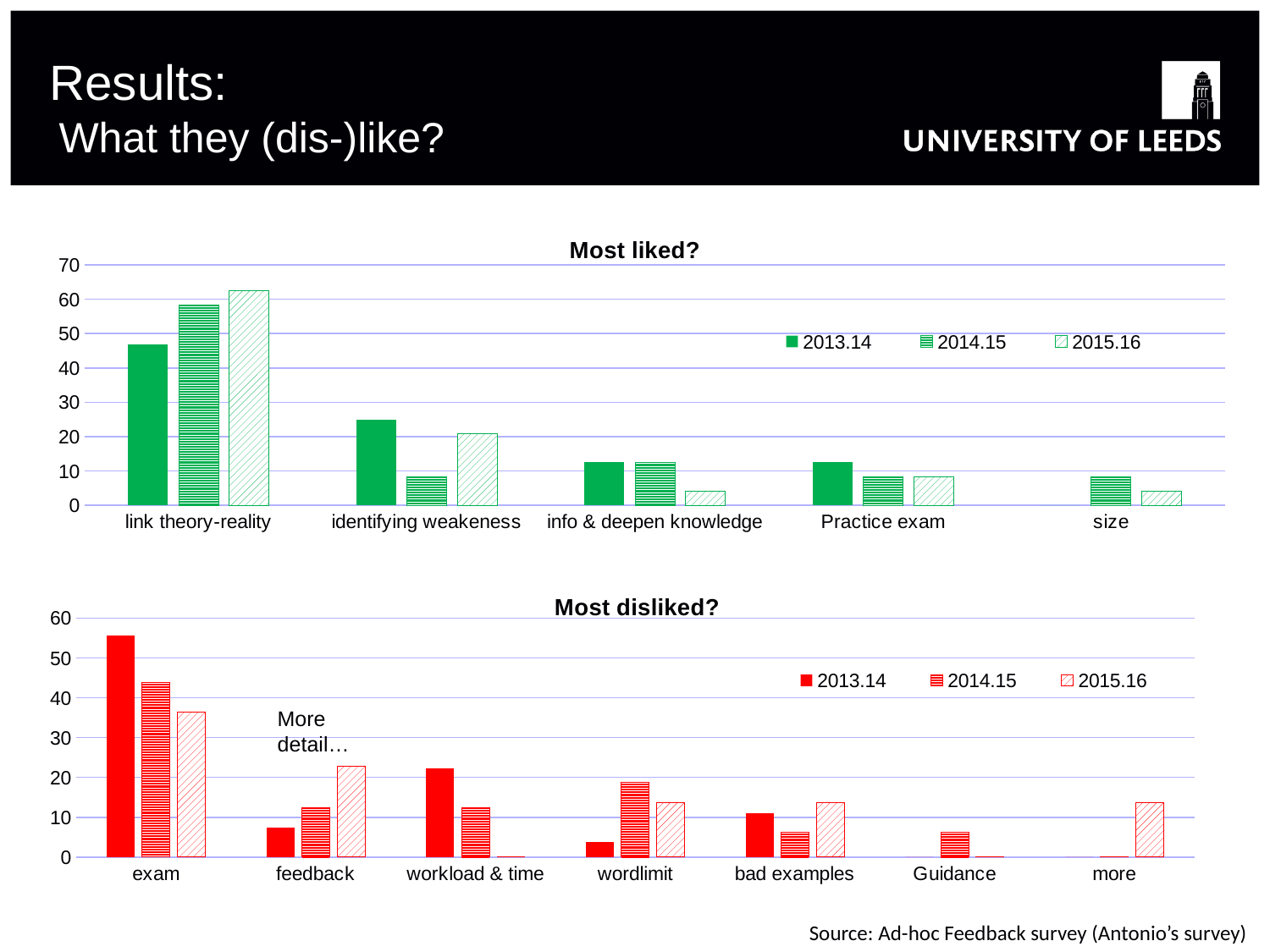
In the "Most disliked?" chart, do the values for exam rise or fall from 2013.14 to 2015.16? fall In the "Most disliked?" chart, is the 2013.14 value for exam greater or less than 50? greater In the "Most disliked?" chart, do the values for feedback rise or fall from 2013.14 to 2015.16? rise In the "Most liked?" chart, which category has the highest value for 2015.16? link theory-reality How many categories are shown on the x axis of the "Most liked?" chart? 5 In the "Most liked?" chart, for identifying weakness, which series is larger: 2013.14 or 2014.15? 2013.14 In the "Most disliked?" chart, which category has the highest value for 2013.14? exam How many series does the legend of the "Most disliked?" chart list? 3 How many categories are shown on the x axis of the "Most disliked?" chart? 7 In the "Most liked?" chart, is the 2014.15 value for link theory-reality greater or less than 50? greater What kind of chart is the "Most liked?" chart? bar chart In the "Most liked?" chart, is the 2013.14 value for identifying weakness greater or less than 20? greater